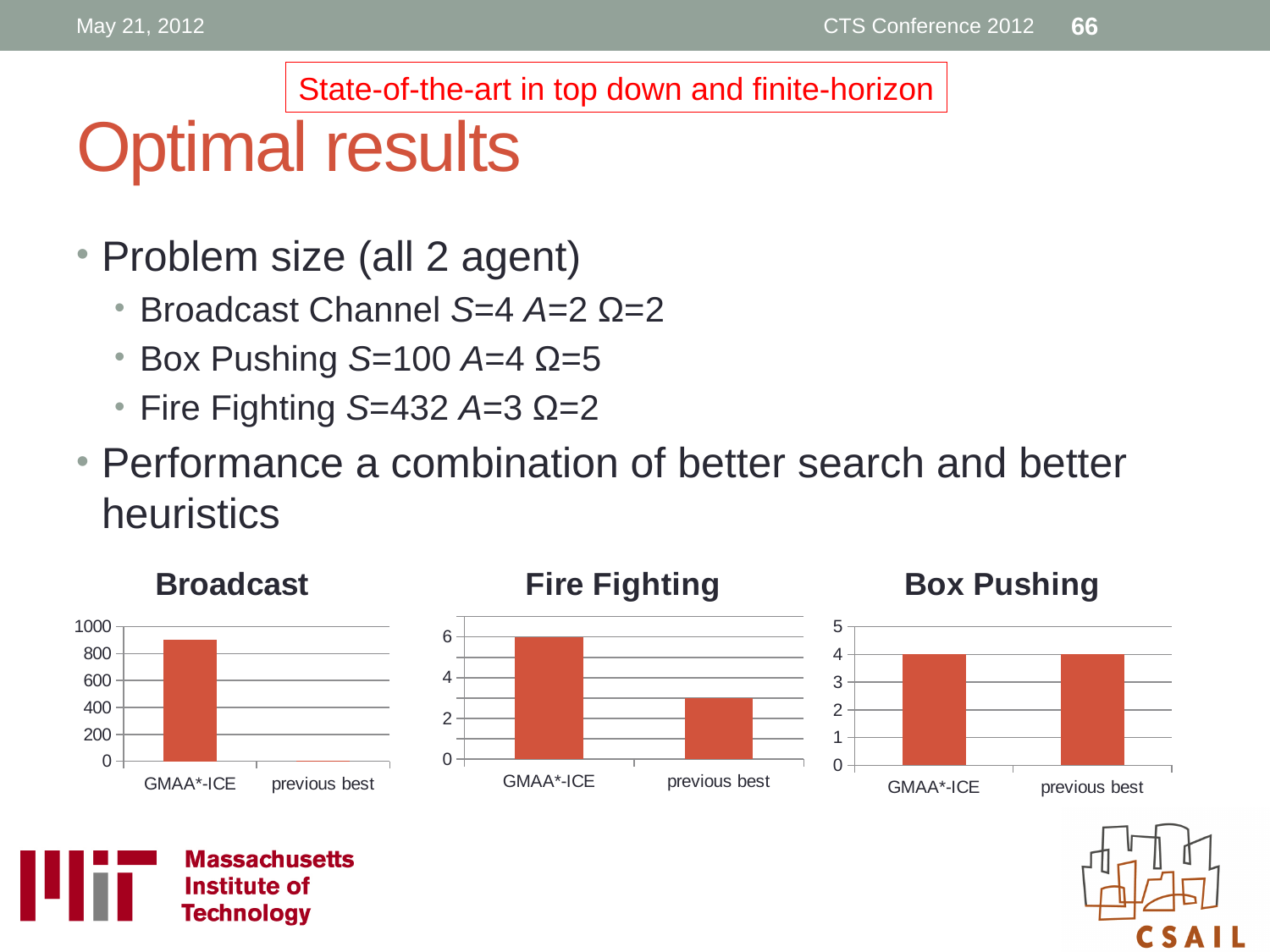
In the Fire Fighting chart, what is the value for GMAA*-ICE? 6 What is the title of the middle chart on the slide? Fire Fighting In the Box Pushing chart, what is the value for GMAA*-ICE? 4 In the Box Pushing chart, what is the value for previous best? 4 In the Broadcast chart, which category has the highest value? GMAA*-ICE In the Broadcast chart, is the value for GMAA*-ICE greater or less than 800? greater In the Fire Fighting chart, how many categories are shown on the x axis? 2 What kind of chart is the Broadcast chart? bar chart In the Fire Fighting chart, which category has the highest value? GMAA*-ICE In the Box Pushing chart, what is the difference between the GMAA*-ICE value and the previous best value? 0